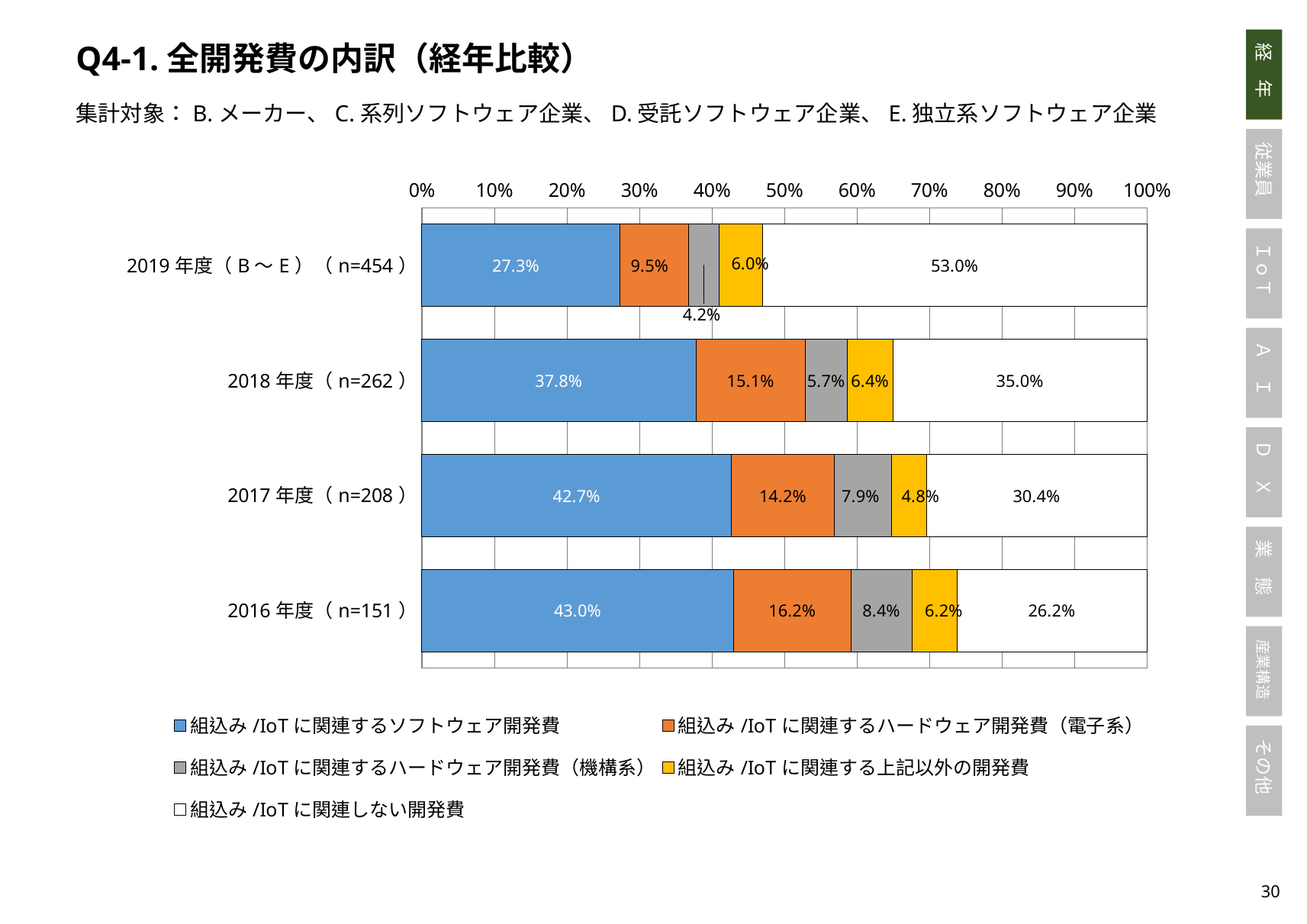
What is the difference between the 組込み/IoTに関連するソフトウェア開発費 values for 2018年度 and 2019年度? 10.5% What kind of chart is shown on the slide? Stacked bar chart How many series does the legend list? 5 What is the value for 組込み/IoTに関連するハードウェア開発費（機構系） in 2019年度 (B〜E)? 4.2% Does the share of 組込み/IoTに関連するソフトウェア開発費 rise or fall from 2016年度 to 2019年度? Fall Which year has the lowest value for 組込み/IoTに関連するハードウェア開発費（機構系）? 2019年度 (B〜E) (n=454) How many years (categories) are shown in the chart? 4 What is the value for 組込み/IoTに関連するソフトウェア開発費 in 2019年度 (B〜E) (n=454)? 27.3% What is the total of the stacked bar for 2019年度 (B〜E) (n=454)? 100.0% Which is larger: 組込み/IoTに関連するハードウェア開発費（電子系） in 2017年度 or in 2018年度? 2018年度 What is the value for 組込み/IoTに関連しない開発費 in 2016年度 (n=151)? 26.2% Which year has the highest value for 組込み/IoTに関連しない開発費? 2019年度 (B〜E) (n=454)